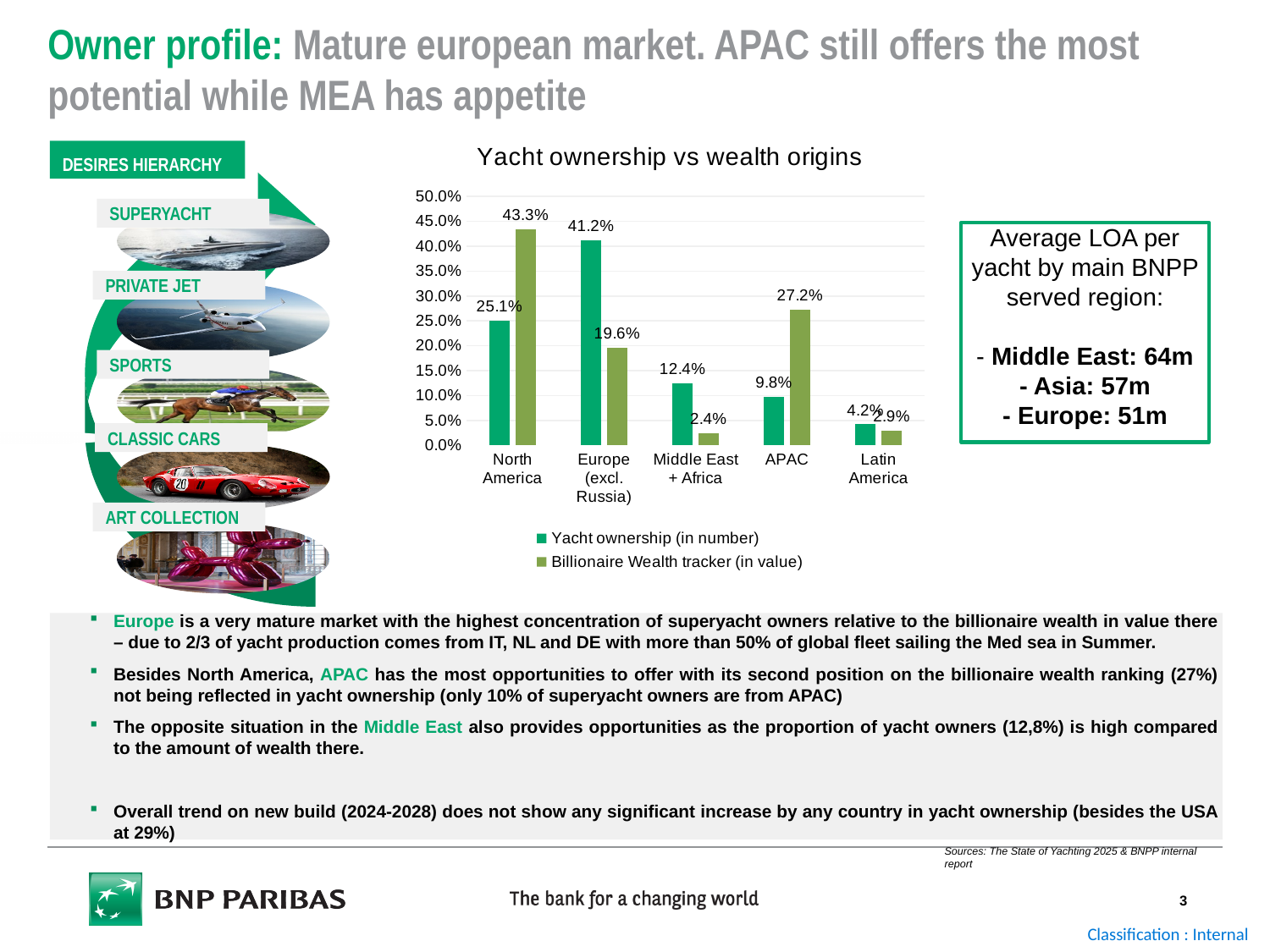
Which region has the highest Yacht ownership (in number) value? Europe (excl. Russia) For North America, which is larger: Yacht ownership (in number) or Billionaire Wealth tracker (in value)? Billionaire Wealth tracker (in value) What is the Billionaire Wealth tracker (in value) value for North America? 43.3% What is the title of the chart? Yacht ownership vs wealth origins What is the Billionaire Wealth tracker (in value) value for Middle East + Africa? 2.4% How many series does the chart's legend list? 2 How many regions are shown on the x axis of the chart? 5 Which region has the lowest Billionaire Wealth tracker (in value) value? Middle East + Africa What is the Yacht ownership (in number) value for APAC? 9.8% What is the difference between the Billionaire Wealth tracker (in value) and Yacht ownership (in number) values for APAC? 17.4% What is the Yacht ownership (in number) value for Europe (excl. Russia)? 41.2% What kind of chart is shown on the slide? Bar chart